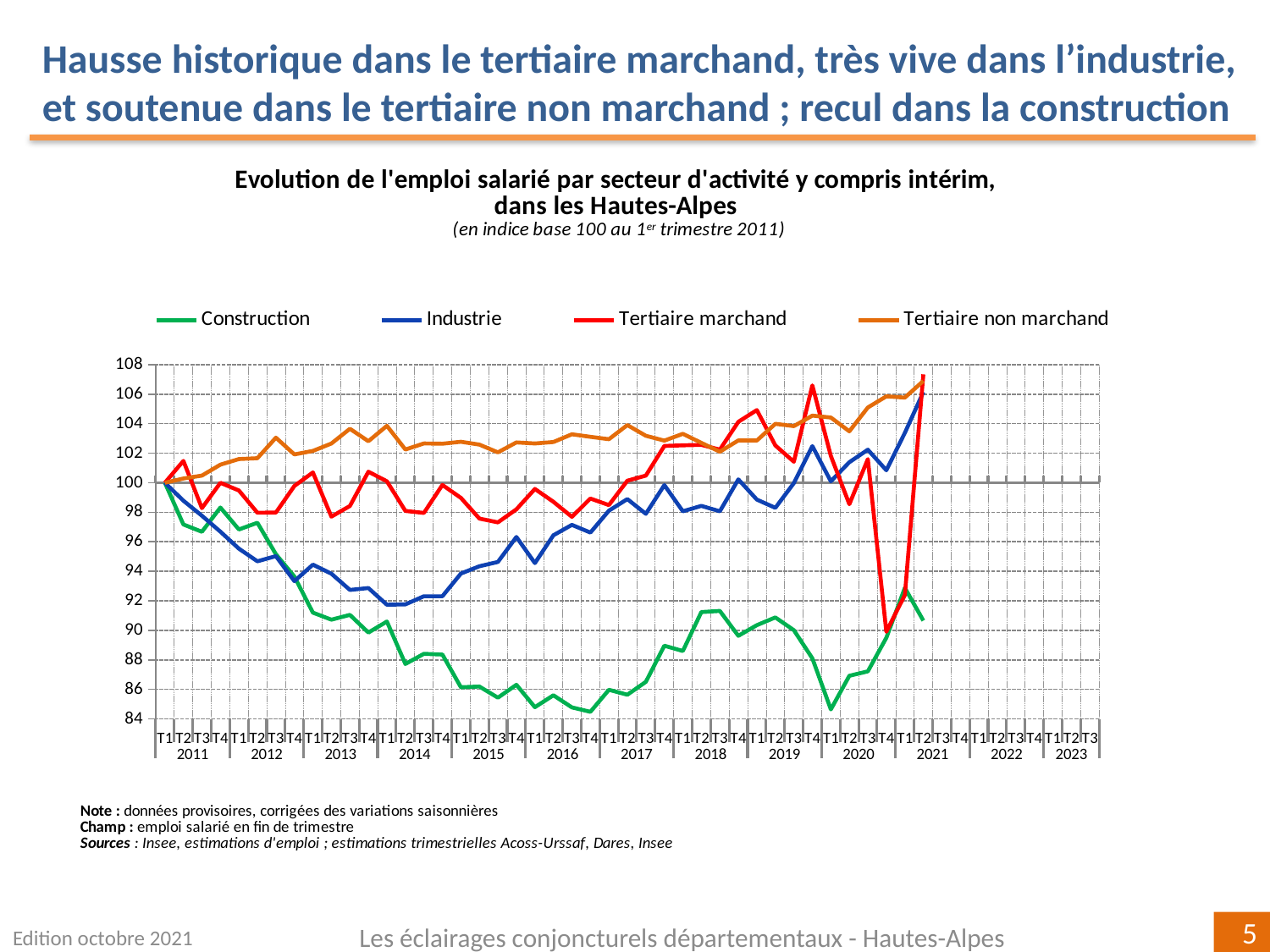
How many series does the legend list? 4 What type of chart is shown on the slide? line chart Which series has the highest value at T4 2019? Tertiaire marchand Does the Construction series rise or fall overall from T1 2011 to T1 2020? fall Is the value for Industrie at T1 2014 greater or less than 94? less Is the value for Tertiaire non marchand at T2 2021 greater or less than 104? greater Is the value for Tertiaire marchand at T4 2020 greater or less than 92? less What is the index value of all four series at T1 2011? 100 At T2 2021, which is larger: Construction or Tertiaire marchand? Tertiaire marchand Which series are listed in the legend? Construction, Industrie, Tertiaire marchand, Tertiaire non marchand Which series has the lowest value at T2 2021? Construction